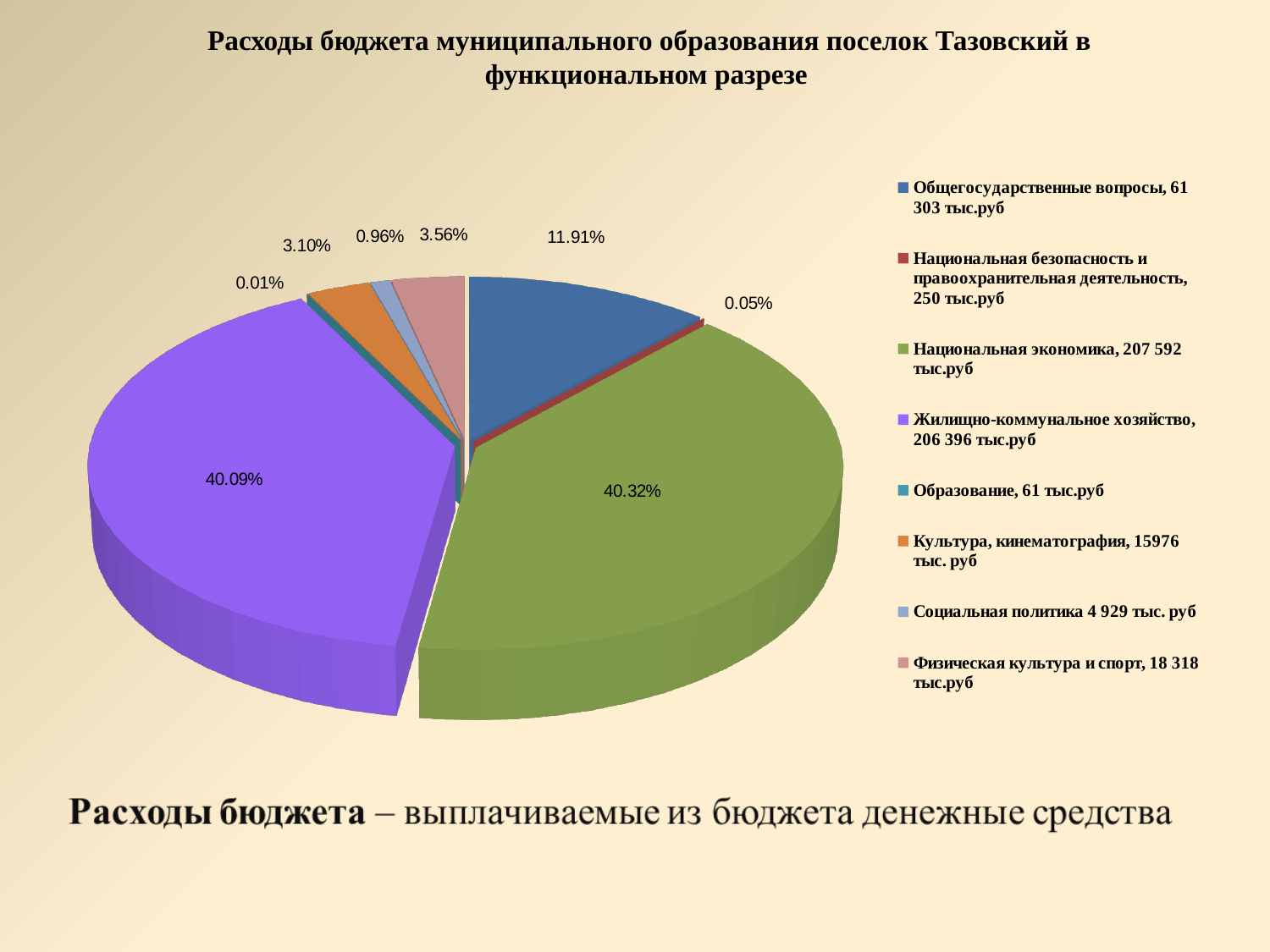
What is the difference in percentage points between the shares of Национальная экономика and Жилищно-коммунальное хозяйство? 0.23 Which category has the largest share of the pie? Национальная экономика What share of the pie does Жилищно-коммунальное хозяйство represent? 40.09% What share of the pie does Национальная экономика represent? 40.32% Which has a larger share: Социальная политика or Физическая культура и спорт? Физическая культура и спорт What share of the pie does Культура, кинематография represent? 3.10% Which category has the smallest share of the pie? Образование What kind of chart is shown on the slide? Pie chart How many categories does the pie chart show? 8 According to the legend, what amount in тыс.руб is given for Национальная экономика? 207 592 тыс.руб